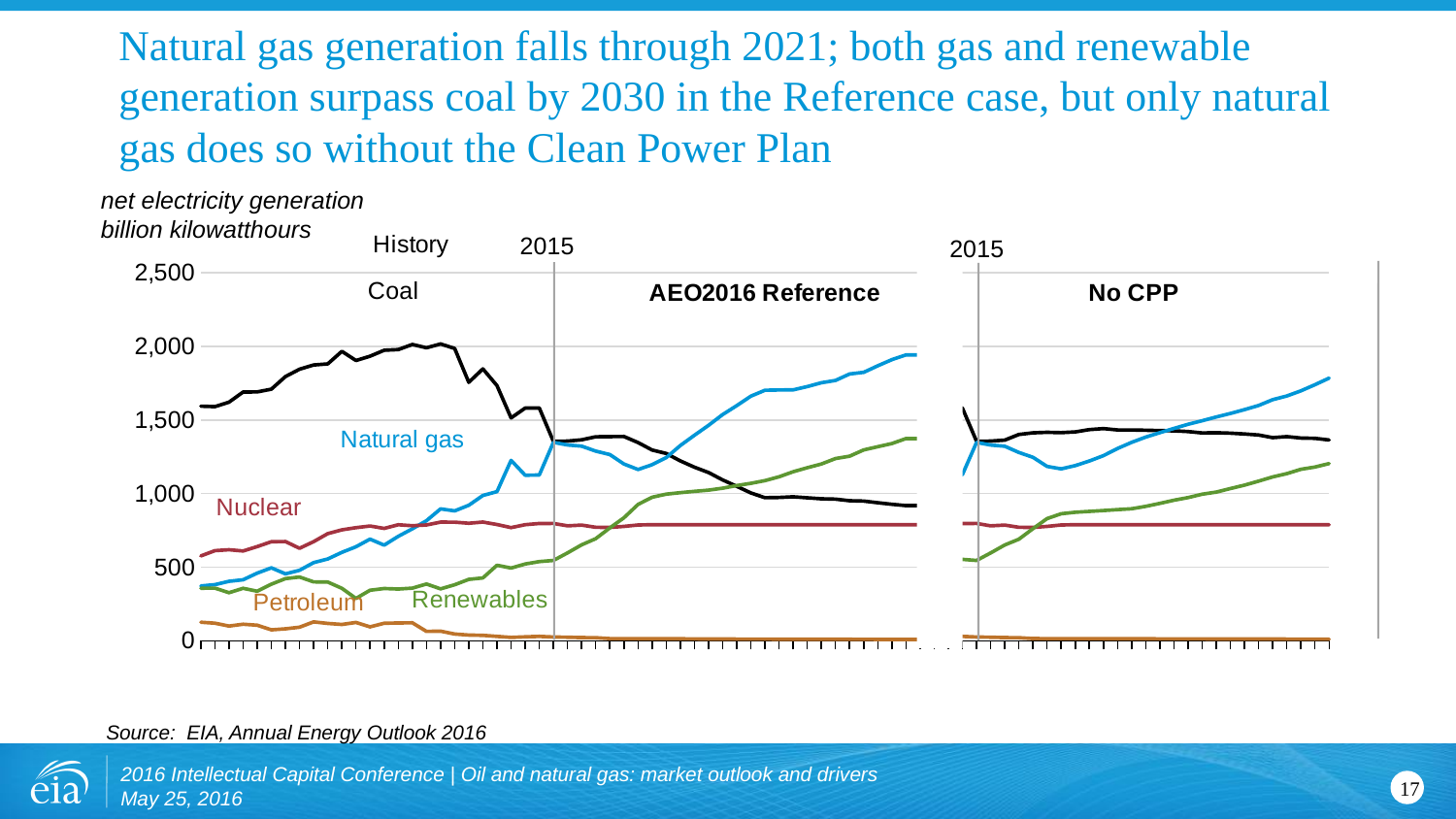
In the AEO2016 Reference panel, does Coal generation rise or fall after 2015? fall In the No CPP panel, which series has the highest generation at the end of the projection? Natural gas What unit is net electricity generation measured in on the chart? billion kilowatthours Which series has the lowest generation throughout the chart? Petroleum Is the peak value of Coal in the History period greater or less than 1,500? greater In the AEO2016 Reference panel, which series has the highest generation at the end of the projection? Natural gas How many fuel series are labeled on the chart? 5 In the AEO2016 Reference panel, is the Nuclear value after 2015 greater or less than 1,000? less What kind of chart is shown on the slide? line chart Which series has the highest generation at the start of the History period? Coal In the AEO2016 Reference panel, does Renewables generation rise or fall after 2015? rise In the No CPP panel, which is larger at the end of the projection, Coal or Renewables? Coal